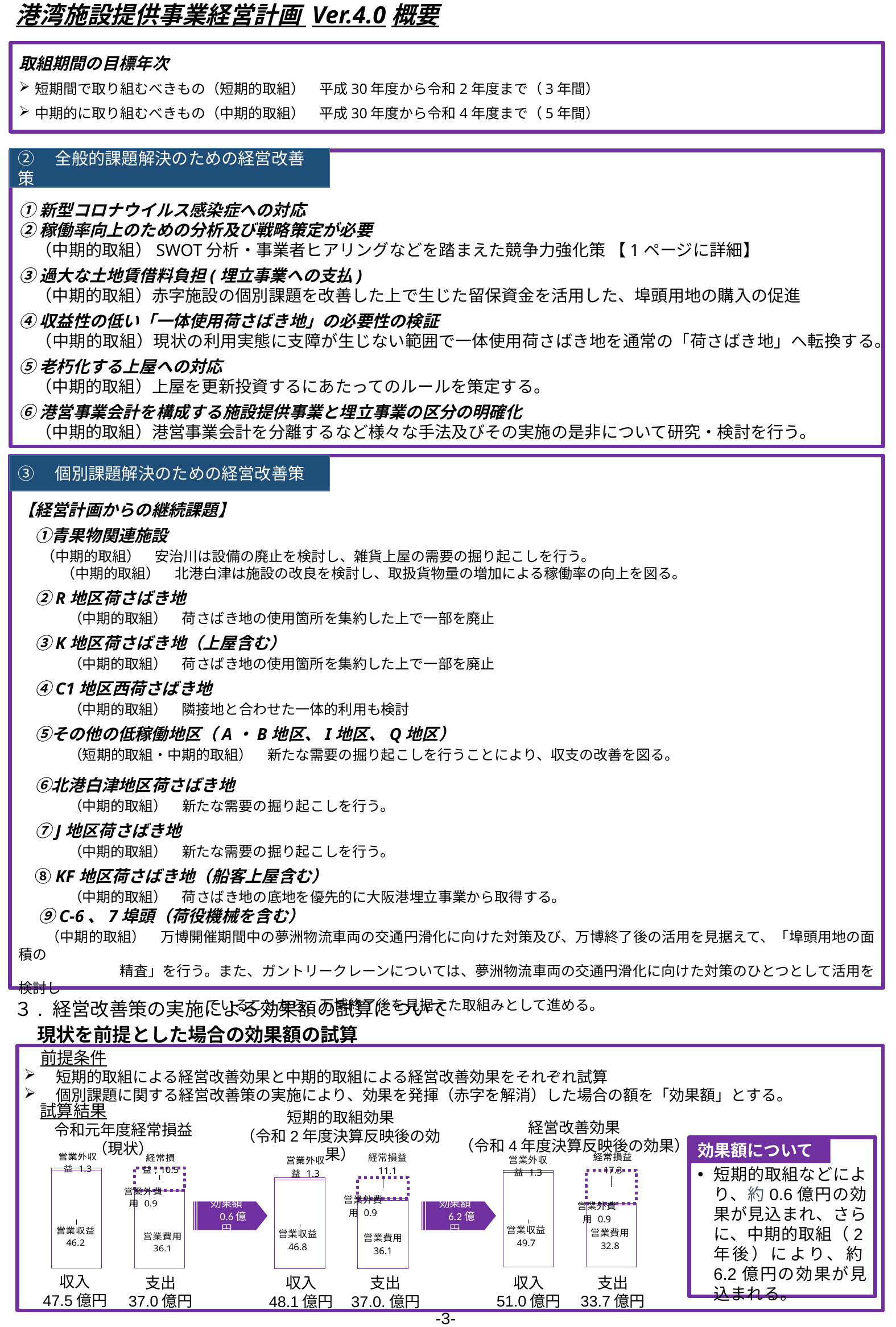
「令和元年度経常損益（現状）」から「短期的取組効果」への効果額はいくらですか？ 0.6億円 「経営改善効果」のグラフで、営業収益と営業費用ではどちらが大きいですか？ 営業収益 「経営改善効果」のグラフで、支出の合計はいくらですか？ 33.7億円 「経営改善効果」のグラフで、支出の営業費用の値はいくらですか？ 32.8 「令和元年度経常損益（現状）」のグラフで、収入の営業収益の値はいくらですか？ 46.2 「令和元年度経常損益（現状）」のグラフはどの種類のグラフですか？ 積み上げ棒グラフ 「令和元年度経常損益（現状）」のグラフで、収入の合計と支出の合計の差はいくらですか？ 10.5億円 「令和元年度経常損益（現状）」のグラフで、支出の営業費用の値はいくらですか？ 36.1 3つのグラフの中で、営業収益が最も大きいのはどのグラフですか？ 経営改善効果 「経営改善効果」のグラフで、収入の合計はいくらですか？ 51.0億円 「短期的取組効果」のグラフで、営業外収益の値は1より大きいですか、小さいですか？ 大きい 「短期的取組効果」のグラフで、収入の営業収益の値はいくらですか？ 46.8